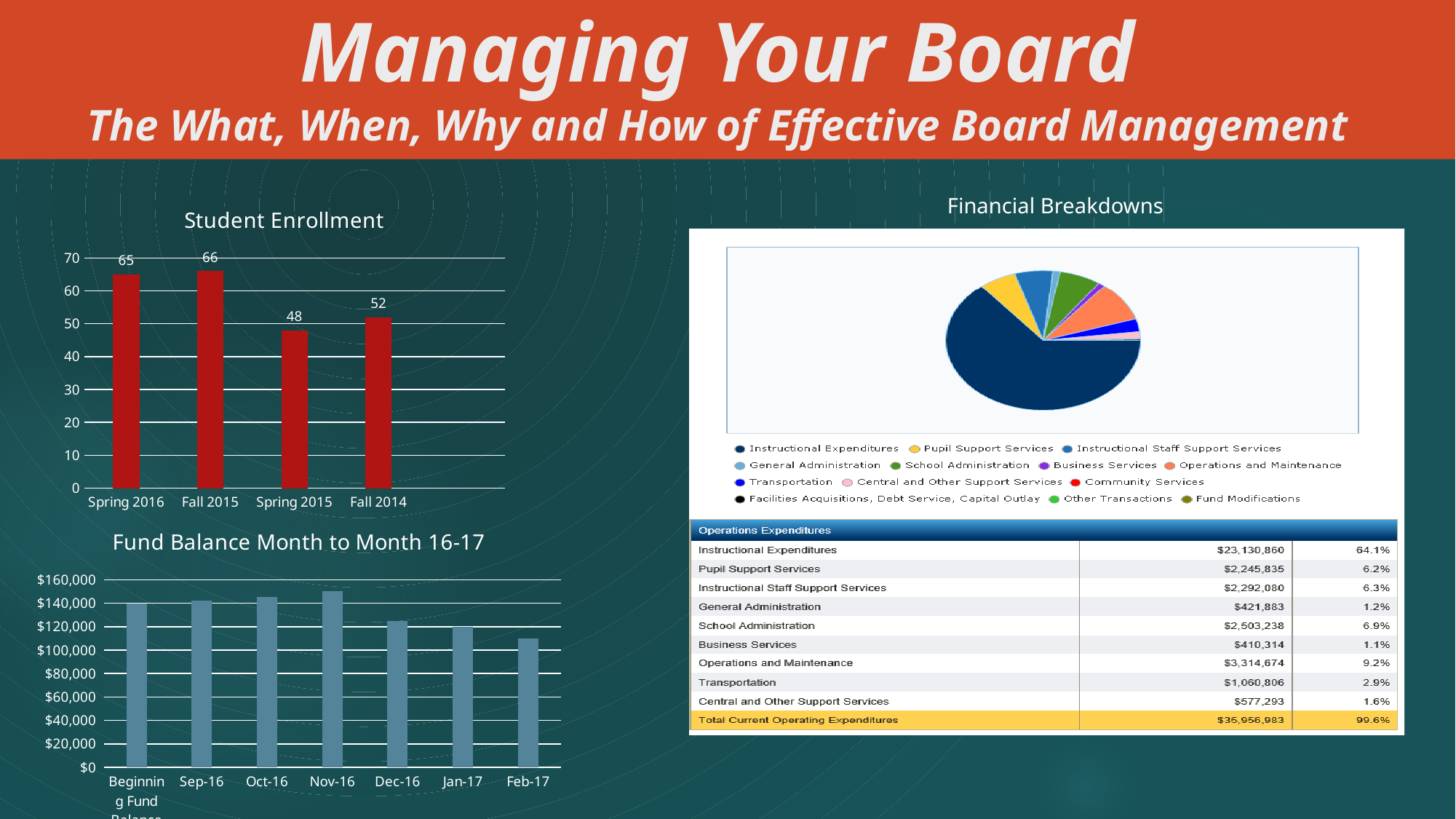
How many periods are shown in the Student Enrollment chart? 4 In the Student Enrollment chart, which period has the lowest enrollment? Spring 2015 In the Fund Balance Month to Month 16-17 chart, is the value for Nov-16 greater or less than $140,000? greater In the Fund Balance Month to Month 16-17 chart, do the values rise or fall from Nov-16 to Feb-17? fall In the Fund Balance Month to Month 16-17 chart, which category has the lowest fund balance? Feb-17 In the Student Enrollment chart, which period has the highest enrollment? Fall 2015 What kind of chart is shown under the Financial Breakdowns title? pie chart In the Financial Breakdowns pie chart, which category has the largest slice? Instructional Expenditures In the Fund Balance Month to Month 16-17 chart, which month has the highest fund balance? Nov-16 In the Student Enrollment chart, what is the difference between the Fall 2015 and Spring 2015 enrollment values? 18 In the Fund Balance Month to Month 16-17 chart, is the value for Feb-17 greater or less than $120,000? less In the Student Enrollment chart, what is the enrollment for Spring 2016? 65